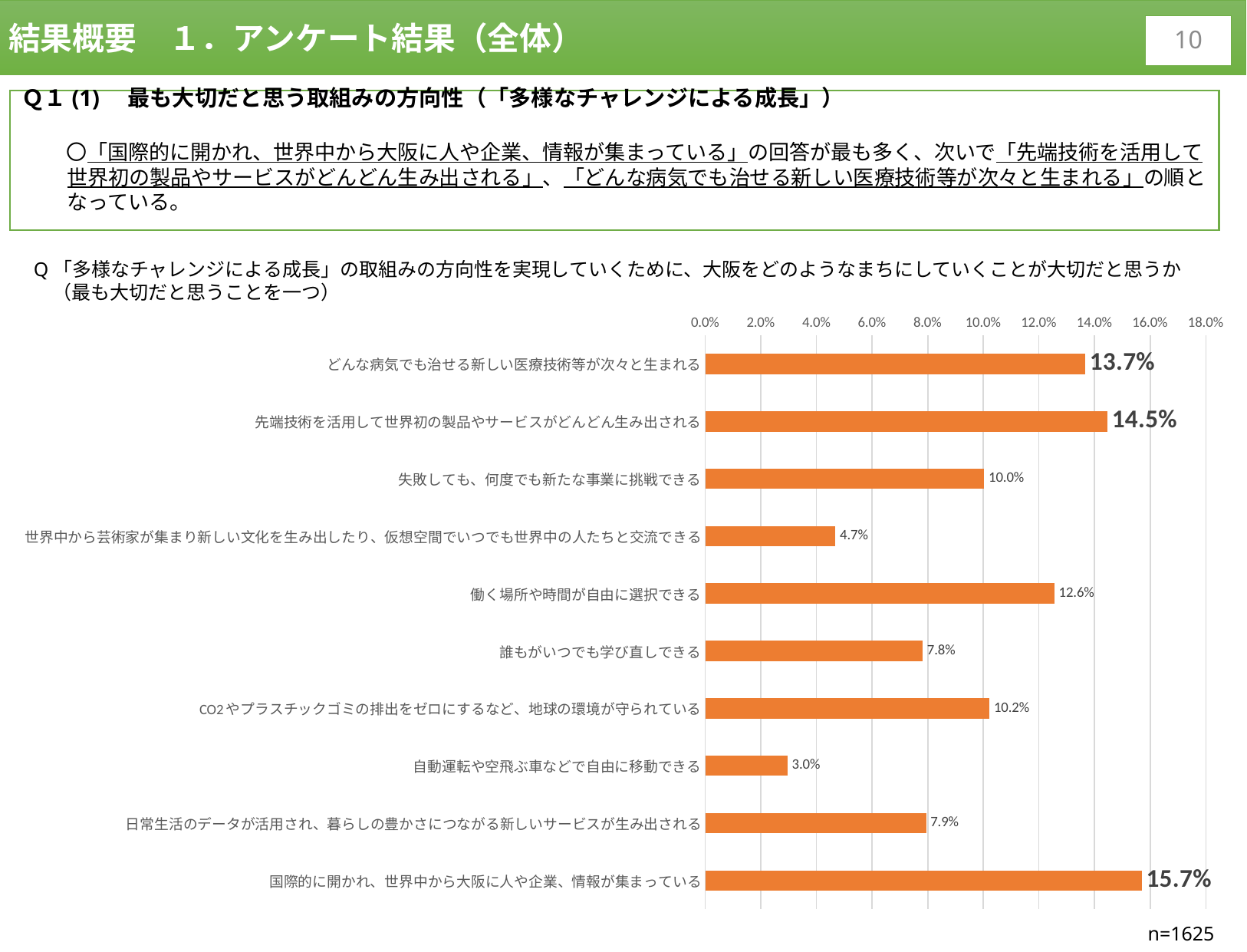
What percentage is shown for 「働く場所や時間が自由に選択できる」? 12.6% What is the difference between 「国際的に開かれ、世界中から大阪に人や企業、情報が集まっている」 and 「先端技術を活用して世界初の製品やサービスがどんどん生み出される」? 1.2 percentage points What kind of chart is shown on the slide? Bar chart What is the difference between 「どんな病気でも治せる新しい医療技術等が次々と生まれる」 and 「失敗しても、何度でも新たな事業に挑戦できる」? 3.7 percentage points Which category has the lowest value in the chart? 自動運転や空飛ぶ車などで自由に移動できる What sample size (n) is shown below the chart? n=1625 How many categories are shown in the chart? 10 What is the value for 「国際的に開かれ、世界中から大阪に人や企業、情報が集まっている」? 15.7% What is the value for 「自動運転や空飛ぶ車などで自由に移動できる」? 3.0% Which is larger: the value for 「働く場所や時間が自由に選択できる」 or for 「CO2やプラスチックゴミの排出をゼロにするなど、地球の環境が守られている」? 働く場所や時間が自由に選択できる Which category has the highest value in the chart? 国際的に開かれ、世界中から大阪に人や企業、情報が集まっている Is the value for 「誰もがいつでも学び直しできる」 greater or less than 8.0%? less